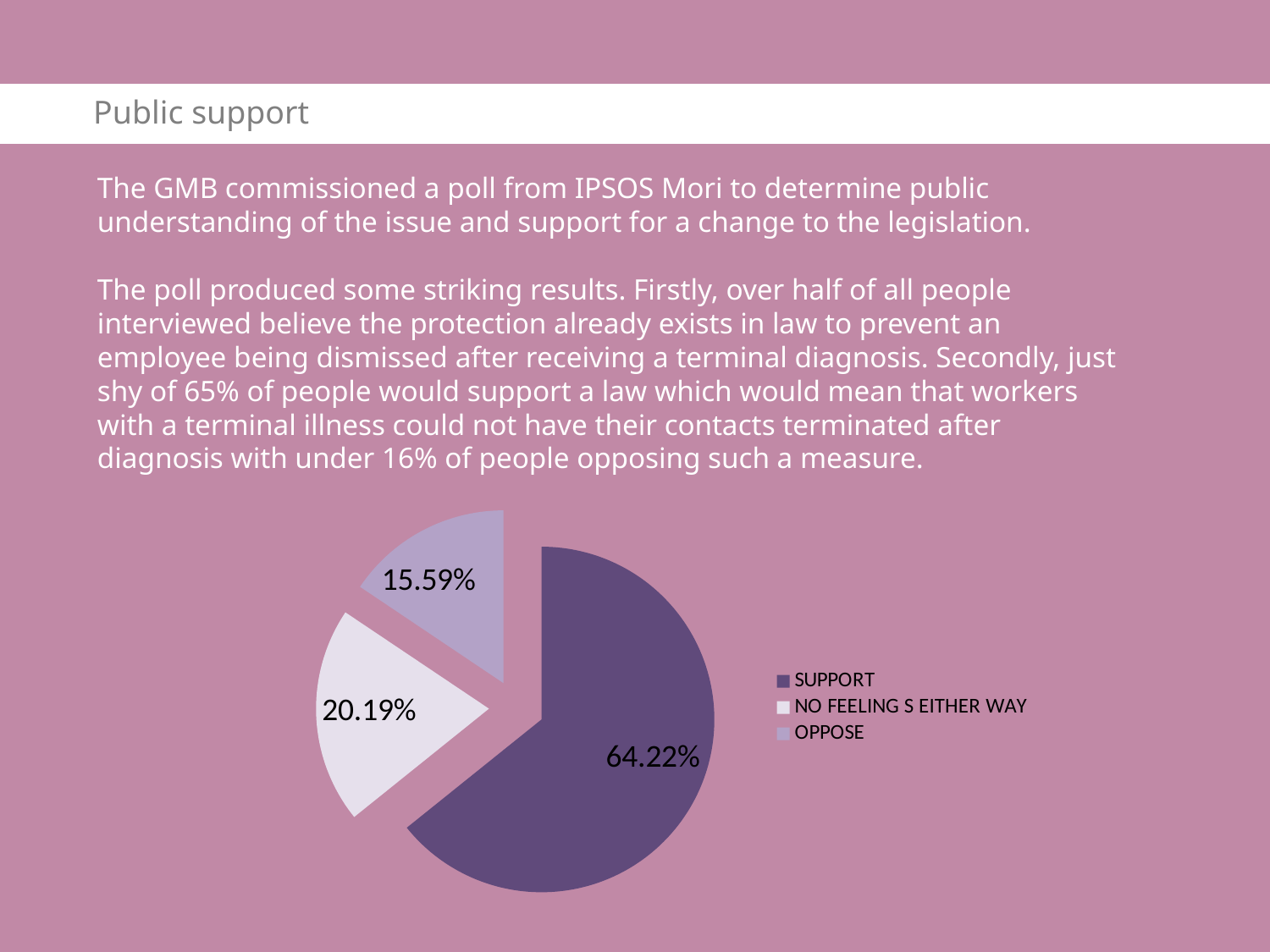
What is the difference between the SUPPORT and OPPOSE values? 48.63% What is the value for NO FEELING S EITHER WAY? 20.19% How many slices does the pie chart have? 3 What is the difference between the NO FEELING S EITHER WAY and OPPOSE values? 4.60% What is the value for OPPOSE? 15.59% How many entries does the legend list? 3 What kind of chart is shown on the slide? pie chart Which category has the smallest share of the pie? OPPOSE Which category has the largest share of the pie? SUPPORT What is the value for SUPPORT? 64.22% Which legend entry is shown in the darkest purple colour? SUPPORT Which is larger, NO FEELING S EITHER WAY or OPPOSE? NO FEELING S EITHER WAY